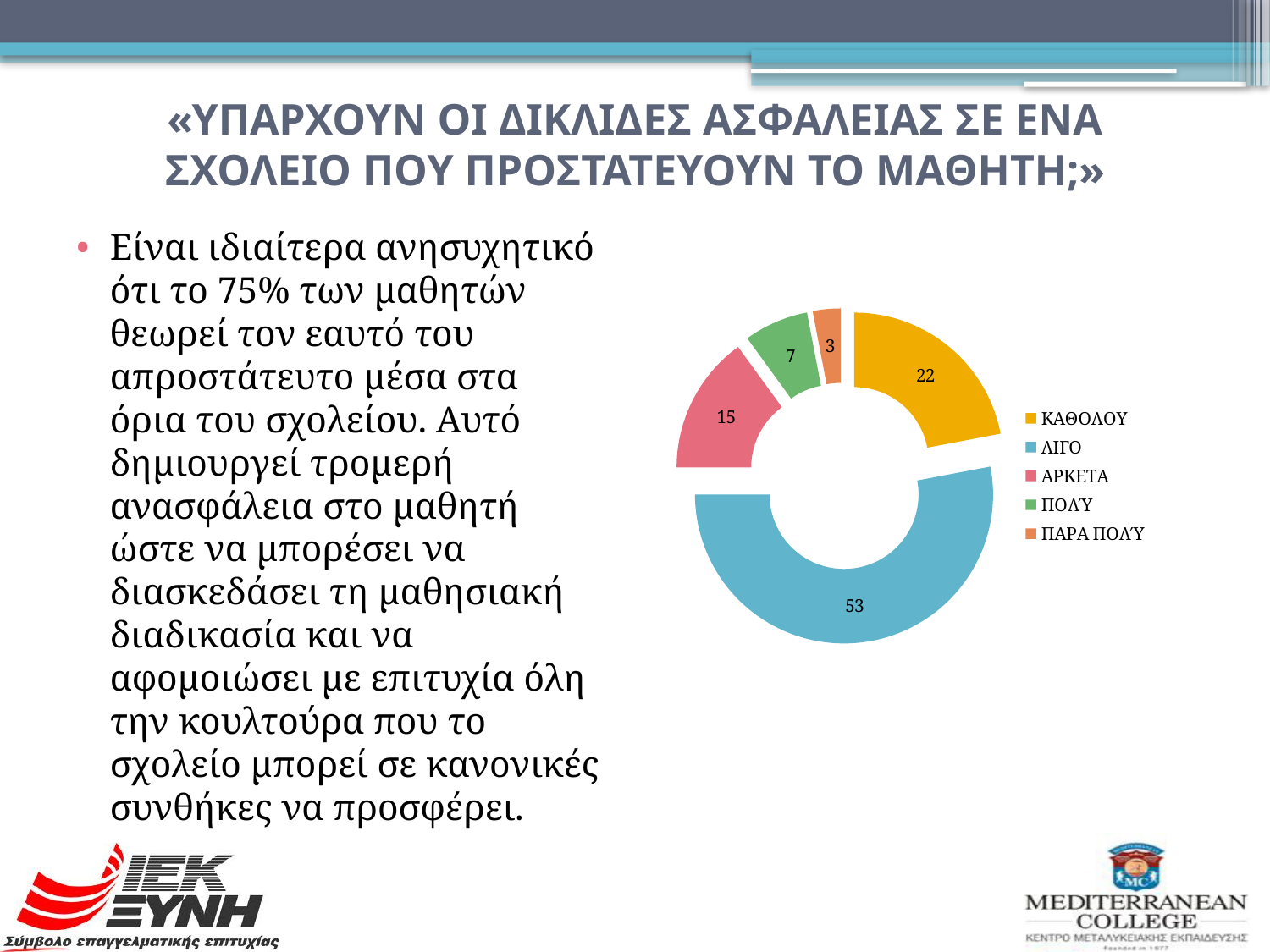
Which category has the largest value in the chart? ΛΙΓΟ What is the difference between the values for ΛΙΓΟ and ΚΑΘΟΛΟΥ? 31 What is the value for ΚΑΘΟΛΟΥ in the chart? 22 What is the value for ΛΙΓΟ in the chart? 53 Which is larger, the value for ΚΑΘΟΛΟΥ or the value for ΑΡΚΕΤΑ? ΚΑΘΟΛΟΥ How many categories does the chart show? 5 What kind of chart is shown on the slide? doughnut chart What share of the total does the ΛΙΓΟ slice represent? 53% Which category has the smallest value in the chart? ΠΑΡΑ ΠΟΛΥ What is the value for ΠΑΡΑ ΠΟΛΥ in the chart? 3 What is the value for ΑΡΚΕΤΑ in the chart? 15 What is the difference between the values for ΑΡΚΕΤΑ and ΠΟΛΥ? 8